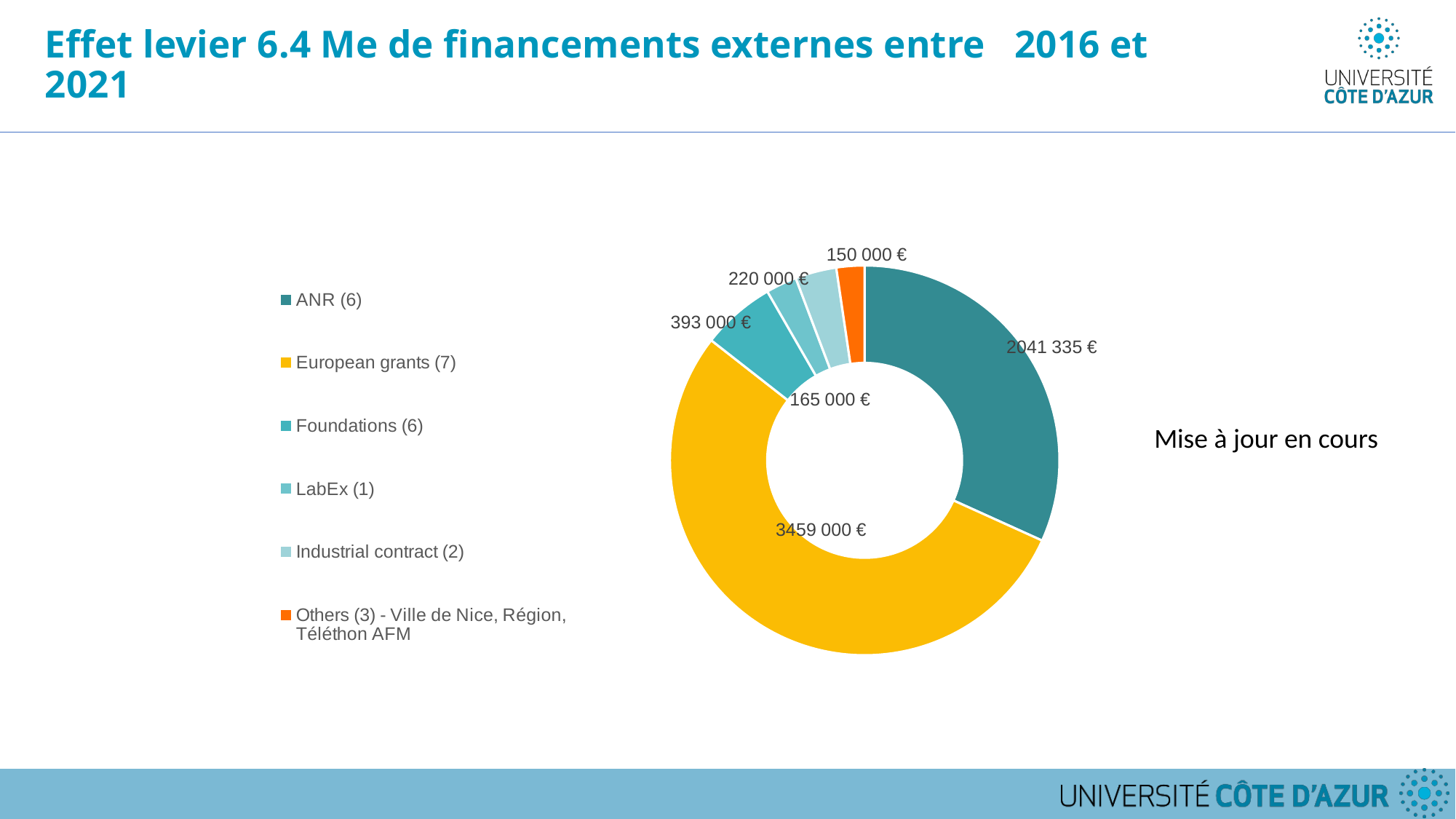
What is the difference between European grants (7) and ANR (6)? 1417 665 € What is the value for Foundations (6)? 393 000 € What kind of chart is shown on the slide? Doughnut (pie) chart What is the value for ANR (6)? 2041 335 € What is the difference between Foundations (6) and Others (3)? 243 000 € What is the value for European grants (7)? 3459 000 € Which category has the largest value? European grants (7) What is the value for Others (3) - Ville de Nice, Région, Téléthon AFM? 150 000 € Which category has the smallest value? Others (3) - Ville de Nice, Région, Téléthon AFM What colour is the European grants (7) slice? Yellow Which is larger, Industrial contract (2) or LabEx (1)? Industrial contract (2) How many categories does the chart show? 6